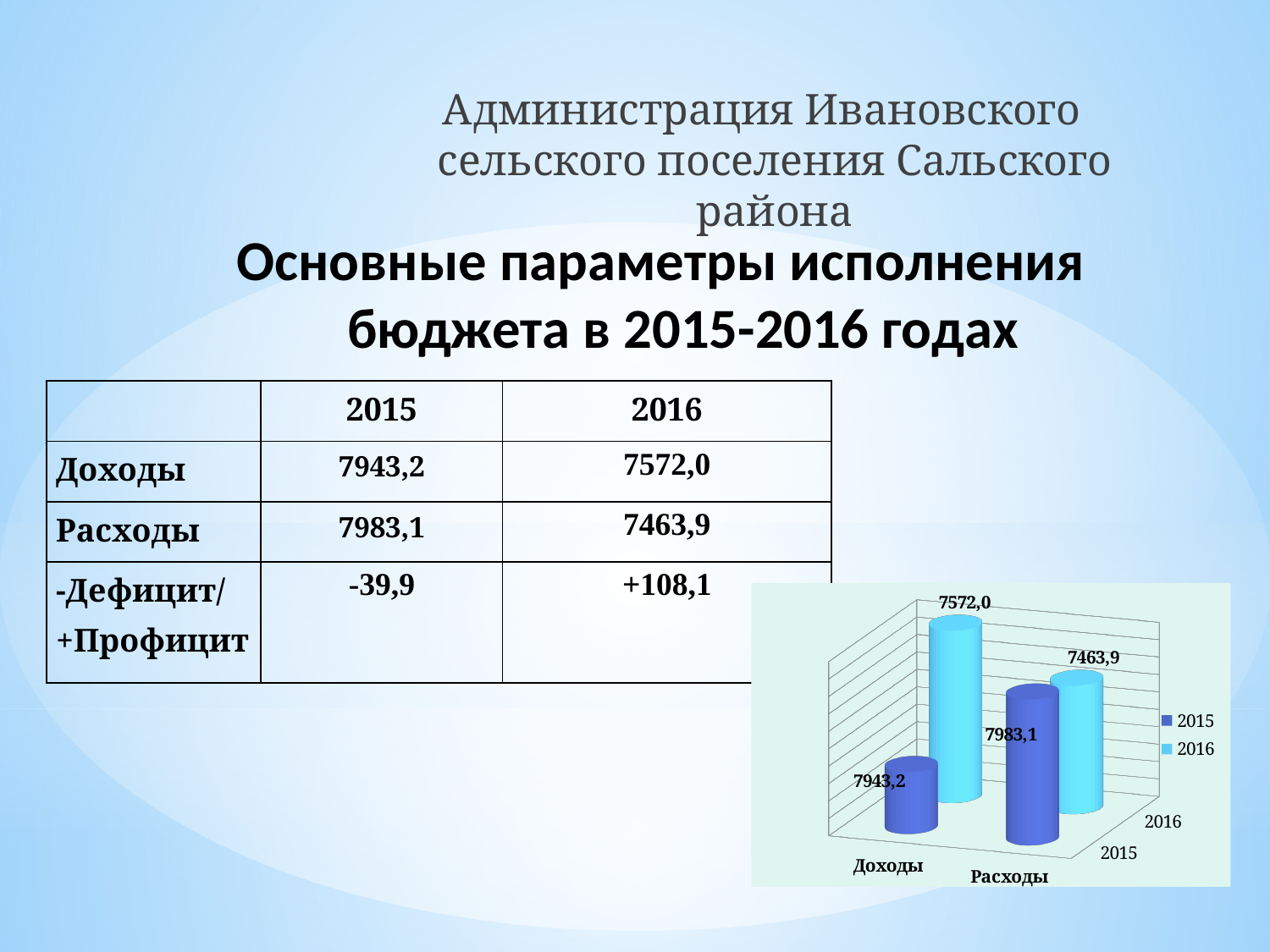
What is the value for Расходы in 2016 on the chart? 7463,9 What is the value for Доходы in 2015 on the chart? 7943,2 How many series does the chart legend list? 2 How many categories are shown on the chart's x axis? 2 Which series is shown in light blue in the chart legend? 2016 What kind of chart is shown on the slide? Bar chart What is the value for Доходы in 2016 on the chart? 7572,0 Which series is larger for Расходы according to the data labels, 2015 or 2016? 2015 Which series is larger for Доходы according to the data labels, 2015 or 2016? 2015 What is the difference between Расходы and Доходы in 2015 according to the chart labels? 39,9 What is the value for Расходы in 2015 on the chart? 7983,1 What is the difference between Доходы and Расходы in 2016 according to the chart labels? 108,1